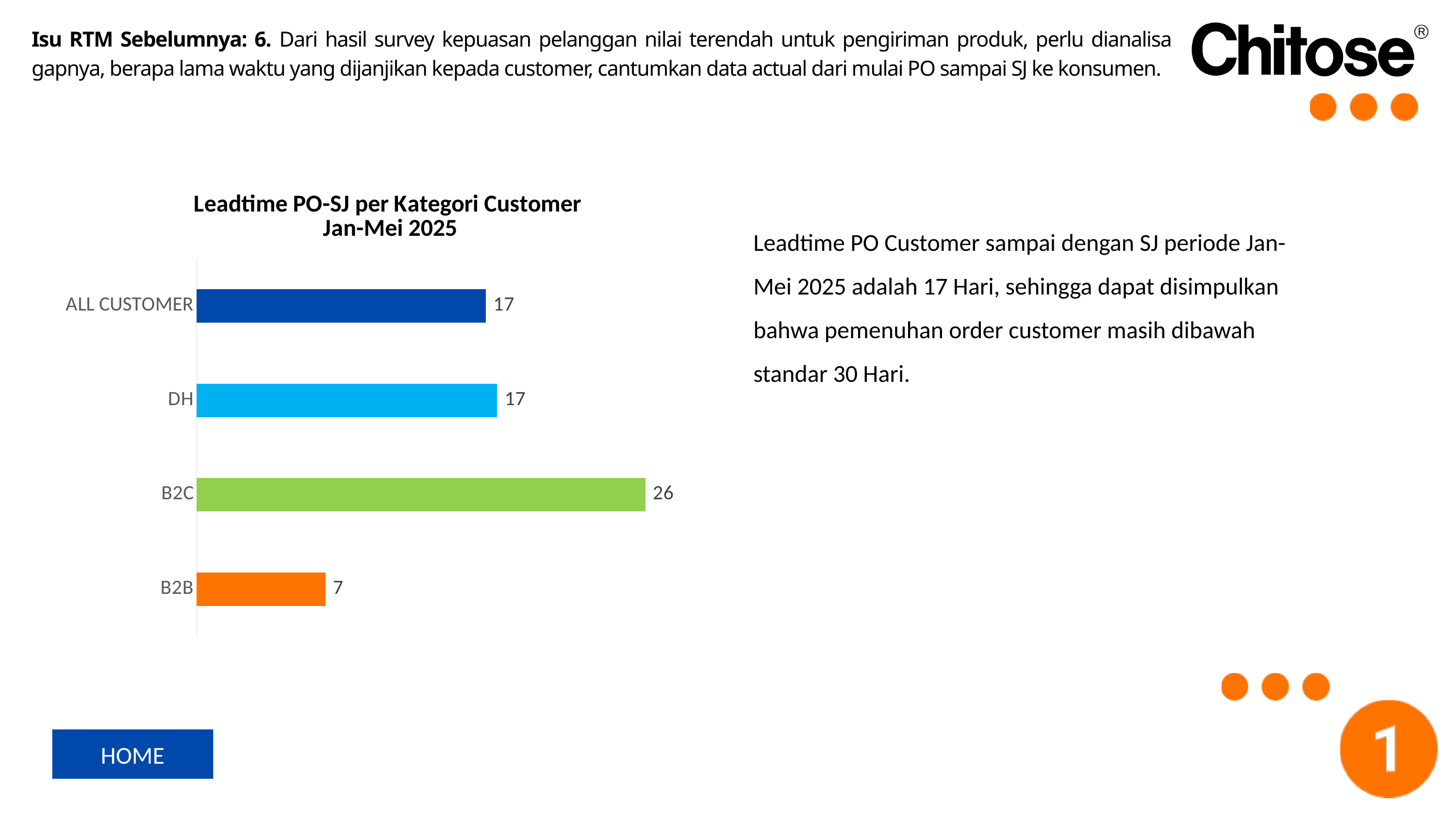
What is the value for ALL CUSTOMER in the chart? 17 What is the difference between the values for B2C and DH? 9 Which category has the highest value? B2C What is the value for B2B in the chart? 7 What is the difference between the values for B2C and B2B? 19 What kind of chart is shown on the slide? Bar chart What is the value for DH in the chart? 17 What is the title of the chart? Leadtime PO-SJ per Kategori Customer Jan-Mei 2025 Which is larger, the value for B2C or the value for ALL CUSTOMER? B2C How many categories are shown in the chart? 4 What is the value for B2C in the chart? 26 Which category has the lowest value? B2B